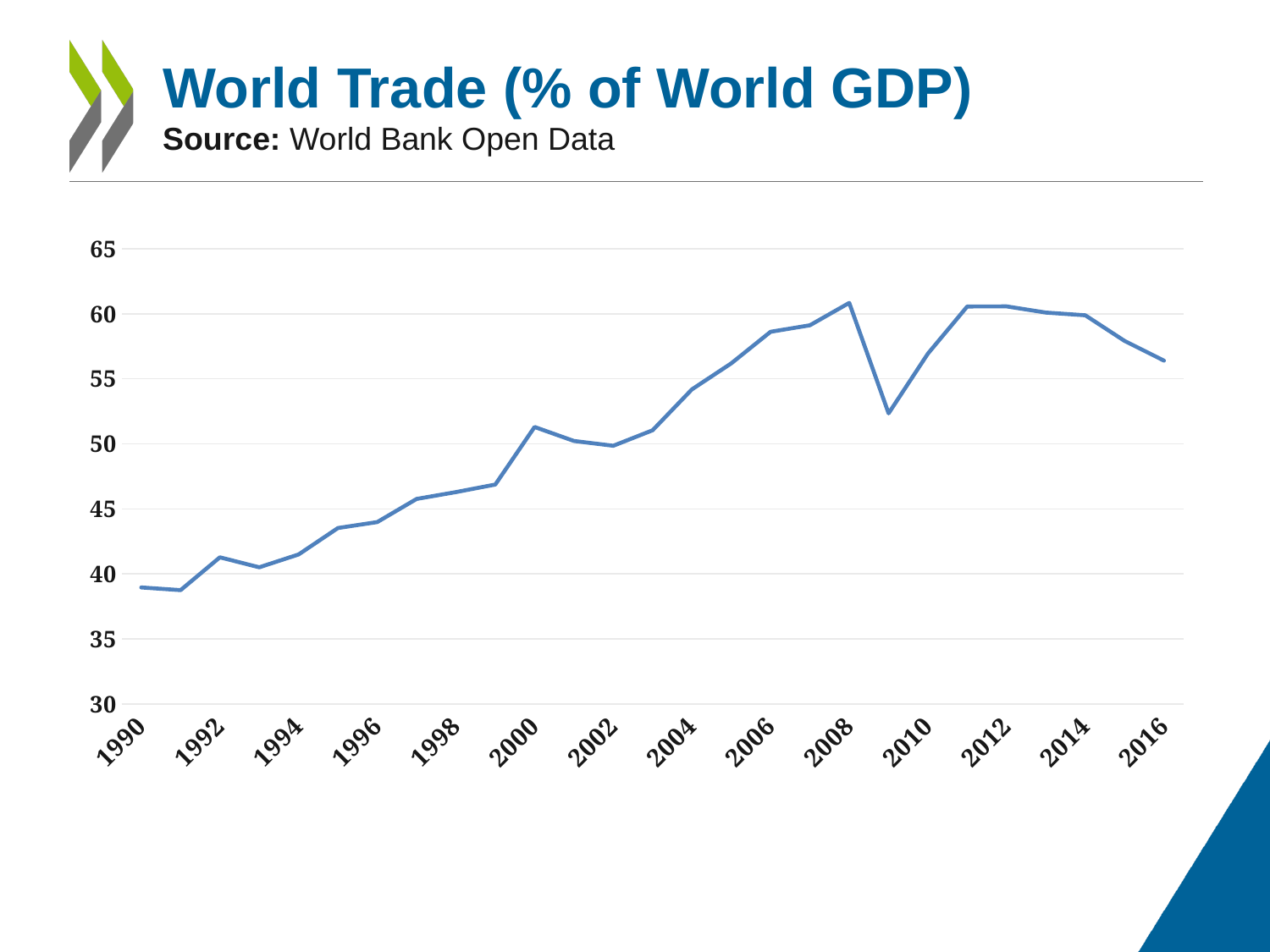
Is the value for 1990 greater or less than 40? less Is the value for 2008 greater or less than 60? greater Is the value for 2009 greater or less than 55? less What source is cited for the chart data? World Bank Open Data Overall, do the values rise or fall from 1990 to 2016? rise Which year has the larger value, 1990 or 2016? 2016 Which year has the larger value, 2008 or 2009? 2008 What kind of chart is shown on the slide? line chart What is the title of the chart? World Trade (% of World GDP)